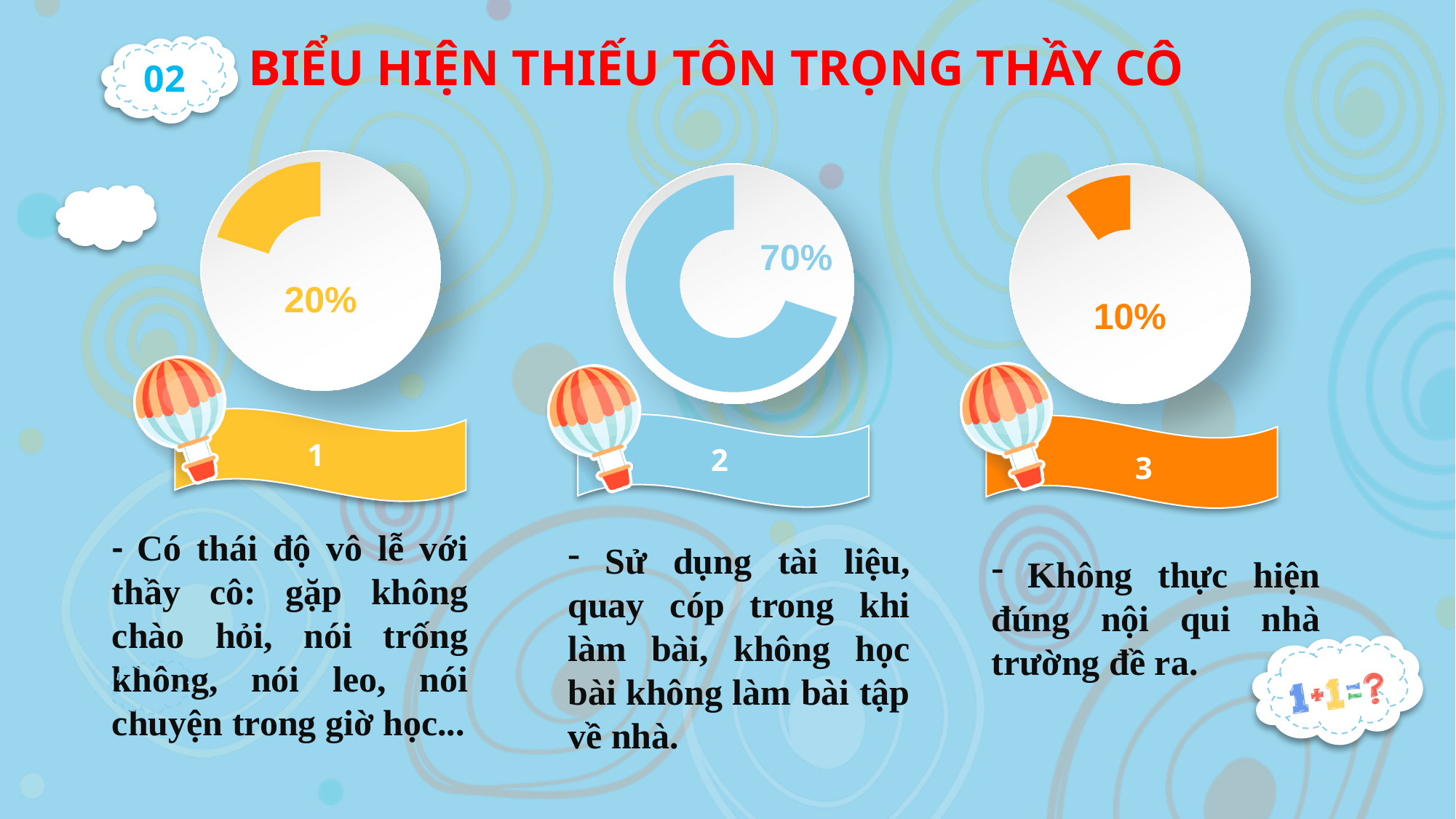
What is the difference between the percentage on chart 1 and the percentage on chart 3? 10% What percentage is shown on the middle chart labelled 2? 70% What colour is the filled segment of the middle chart labelled 2? Blue What colour is the filled segment of the right chart labelled 3? Orange How many charts are shown on the slide? 3 What percentage is shown on the left chart labelled 1? 20% What is the difference between the percentage on chart 2 and the percentage on chart 1? 50% What percentage is shown on the right chart labelled 3? 10% Which of the three charts shows the highest percentage? Chart 2 (70%) Which is larger, the percentage on chart 1 or the percentage on chart 3? Chart 1 What kind of chart is used for the three percentages on the slide? Donut (pie) chart Which of the three charts shows the lowest percentage? Chart 3 (10%)